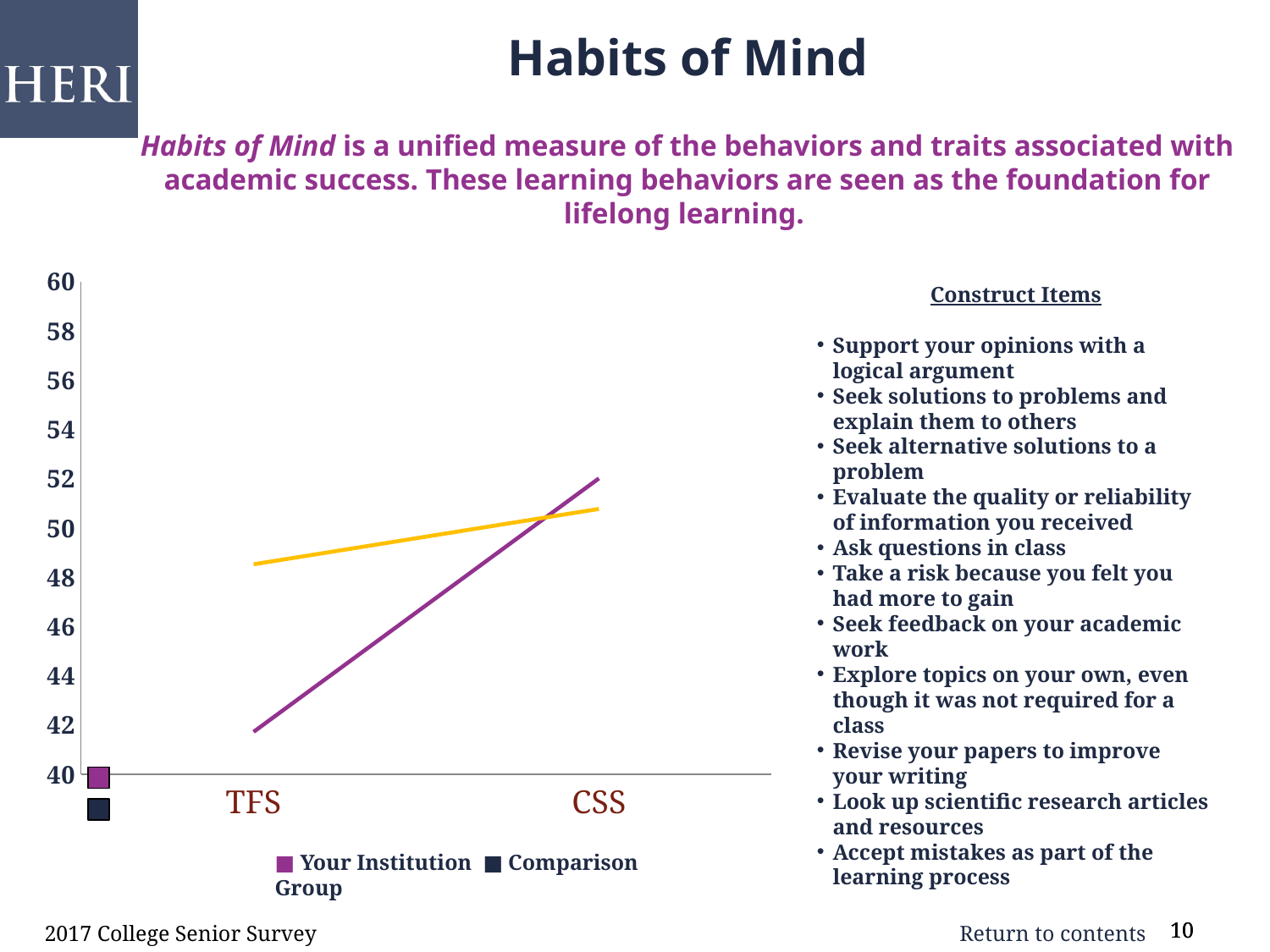
Is the Your Institution (purple) value at CSS greater or less than 50? greater What are the two series named in the chart legend? Your Institution and Comparison Group At CSS, which line is higher, the purple line or the yellow line? the purple line What kind of chart is shown on the slide? line chart Is the yellow line's value at TFS greater or less than 46? greater Does the Your Institution (purple) line rise or fall from TFS to CSS? rise What are the two categories on the x axis of the chart? TFS and CSS At TFS, which line is higher, the purple line or the yellow line? the yellow line How many categories are shown on the x axis of the chart? 2 Does the yellow line rise or fall from TFS to CSS? rise How many series does the chart legend list? 2 Is the Your Institution (purple) value at TFS greater or less than 44? less